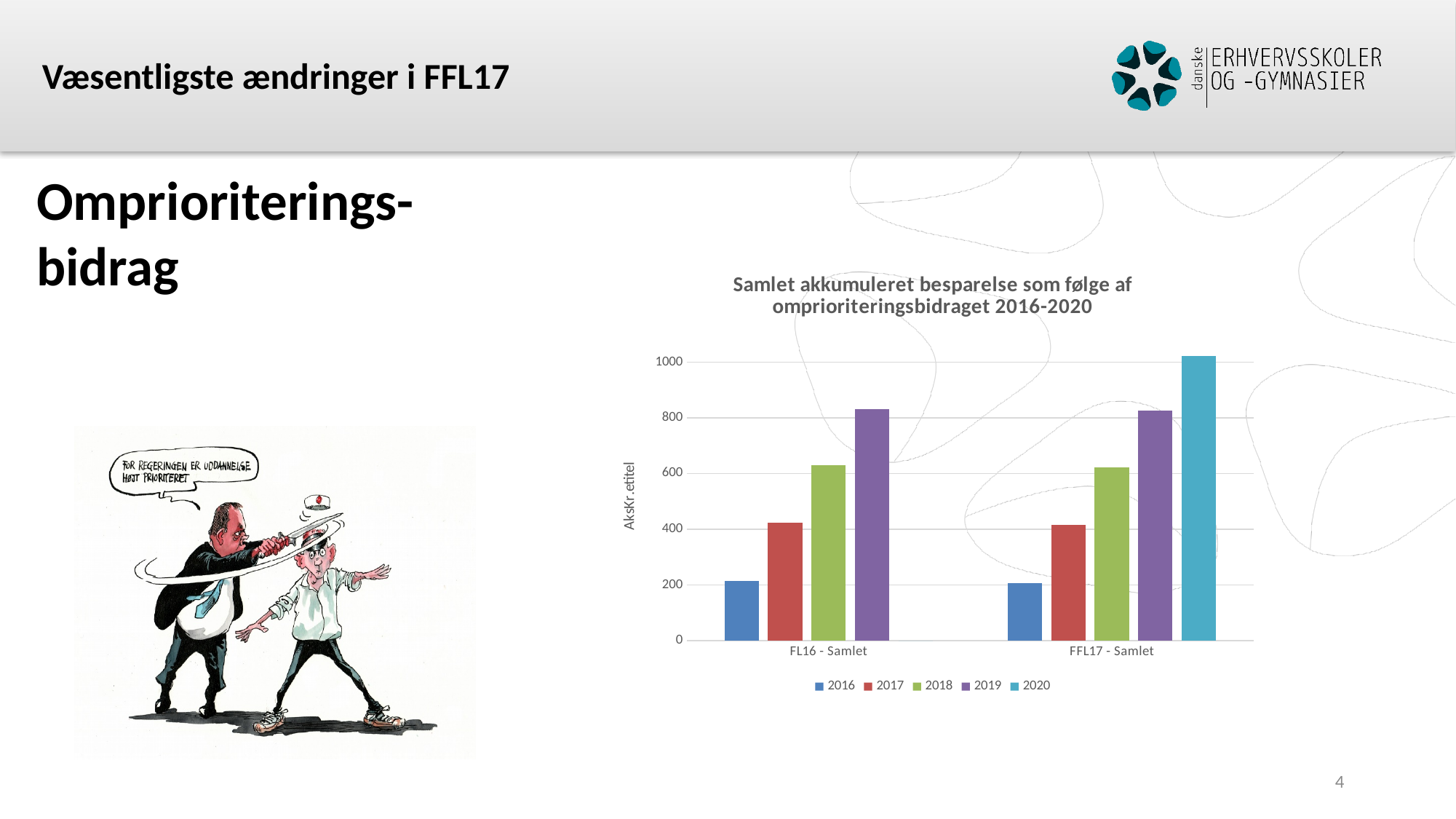
Is the value for 2017 in the FFL17 - Samlet group greater or less than 600? less Which series has the highest bar in the FFL17 - Samlet group? 2020 Within the FFL17 - Samlet group, do the bars rise or fall from 2016 to 2020? rise What kind of chart is shown on the slide? bar chart In the FL16 - Samlet group, which is larger: the 2018 bar or the 2019 bar? 2019 How many series does the legend list? 5 How many categories are shown on the x axis? 2 Which category has a bar for the 2020 series? FFL17 - Samlet Is the value for 2020 in the FFL17 - Samlet group greater or less than 1000? greater Is the value for 2018 in the FL16 - Samlet group greater or less than 600? greater Which series has the lowest bar in the FFL17 - Samlet group? 2016